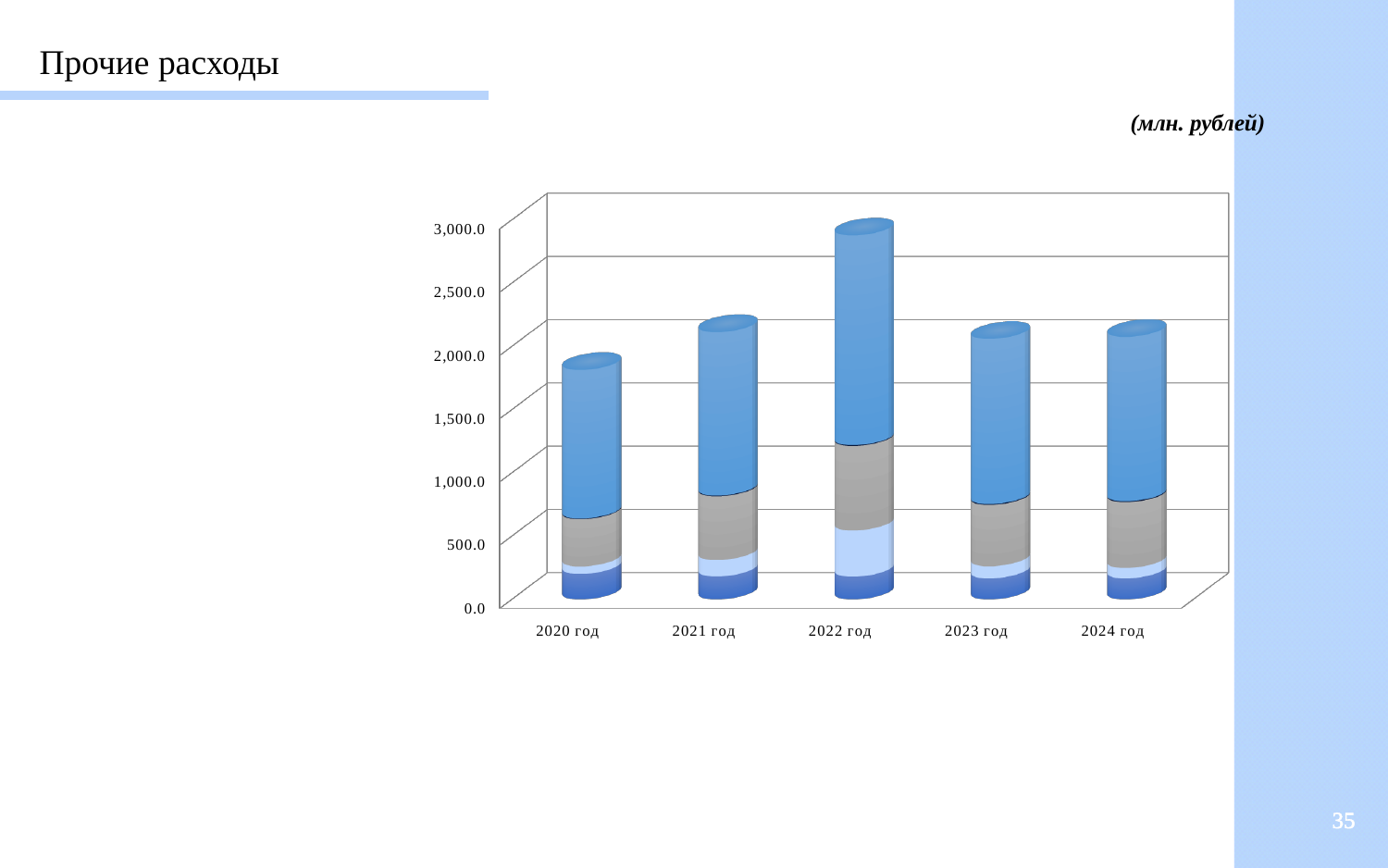
Which total is larger, 2021 год or 2022 год? 2022 год Is the total for 2020 год greater or less than 2,500.0? less What kind of chart is shown on the slide? Stacked bar chart How many years (categories) are shown on the x axis of the chart? 5 Which total is larger, 2020 год or 2022 год? 2022 год Which year has the lowest total bar in the chart? 2020 год Is the total for 2021 год greater or less than 1,500.0? greater What unit of measurement is indicated for the chart on the slide? млн. рублей Is the total for 2023 год greater or less than 3,000.0? less Which year has the highest total bar in the chart? 2022 год